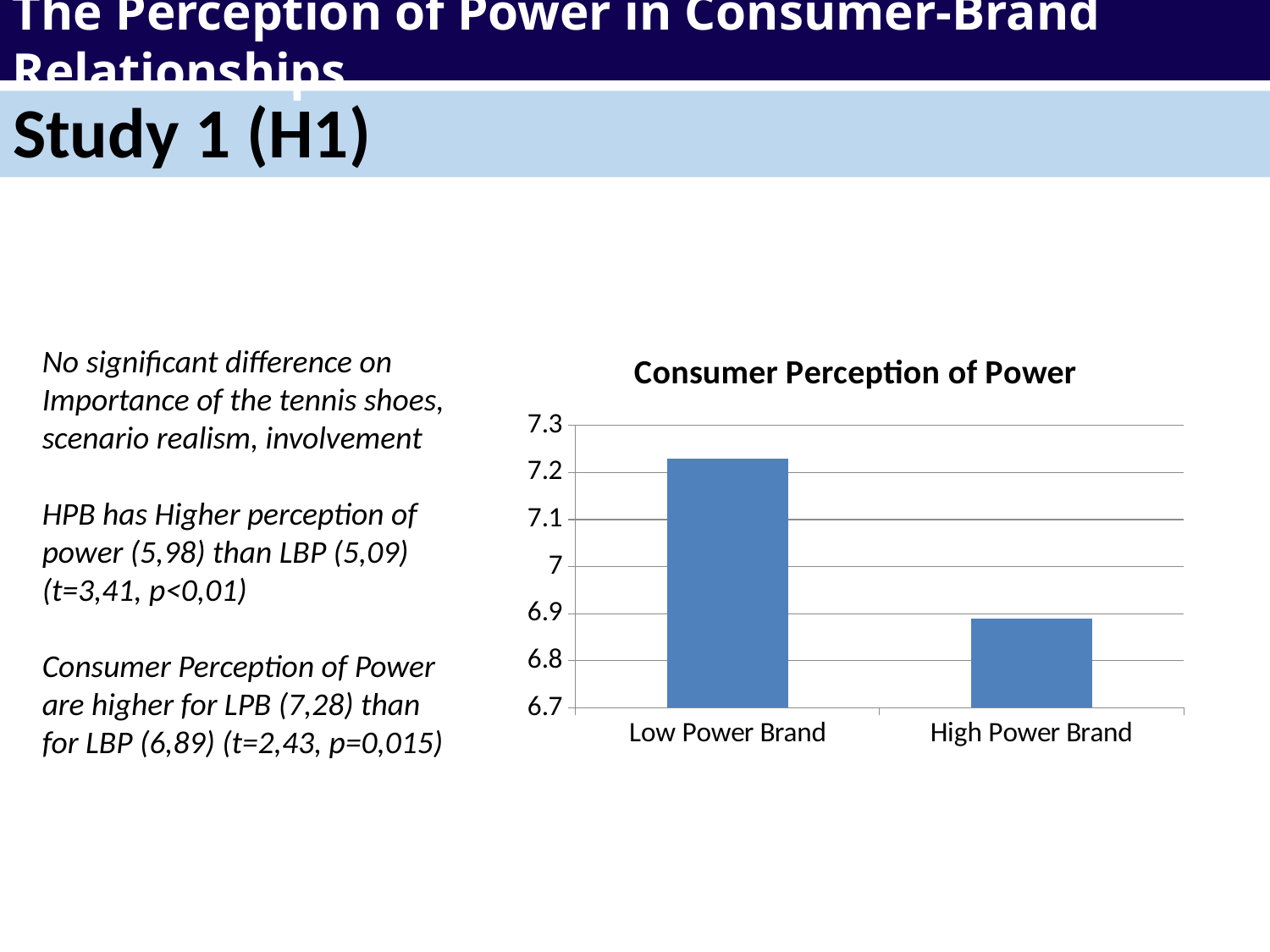
Which category has the lowest value in the chart? High Power Brand Which is larger, the value for Low Power Brand or the value for High Power Brand? Low Power Brand Is the value for Low Power Brand greater or less than 7? greater Is the value for High Power Brand greater or less than 6.8? greater Is the value for High Power Brand greater or less than 7? less What colour are the bars in the chart? Blue Which category has the highest value in the chart? Low Power Brand What kind of chart is shown on the slide? Bar chart What is the title of the chart? Consumer Perception of Power How many categories are plotted in the chart? 2 Do the values rise or fall from Low Power Brand to High Power Brand along the x axis? fall